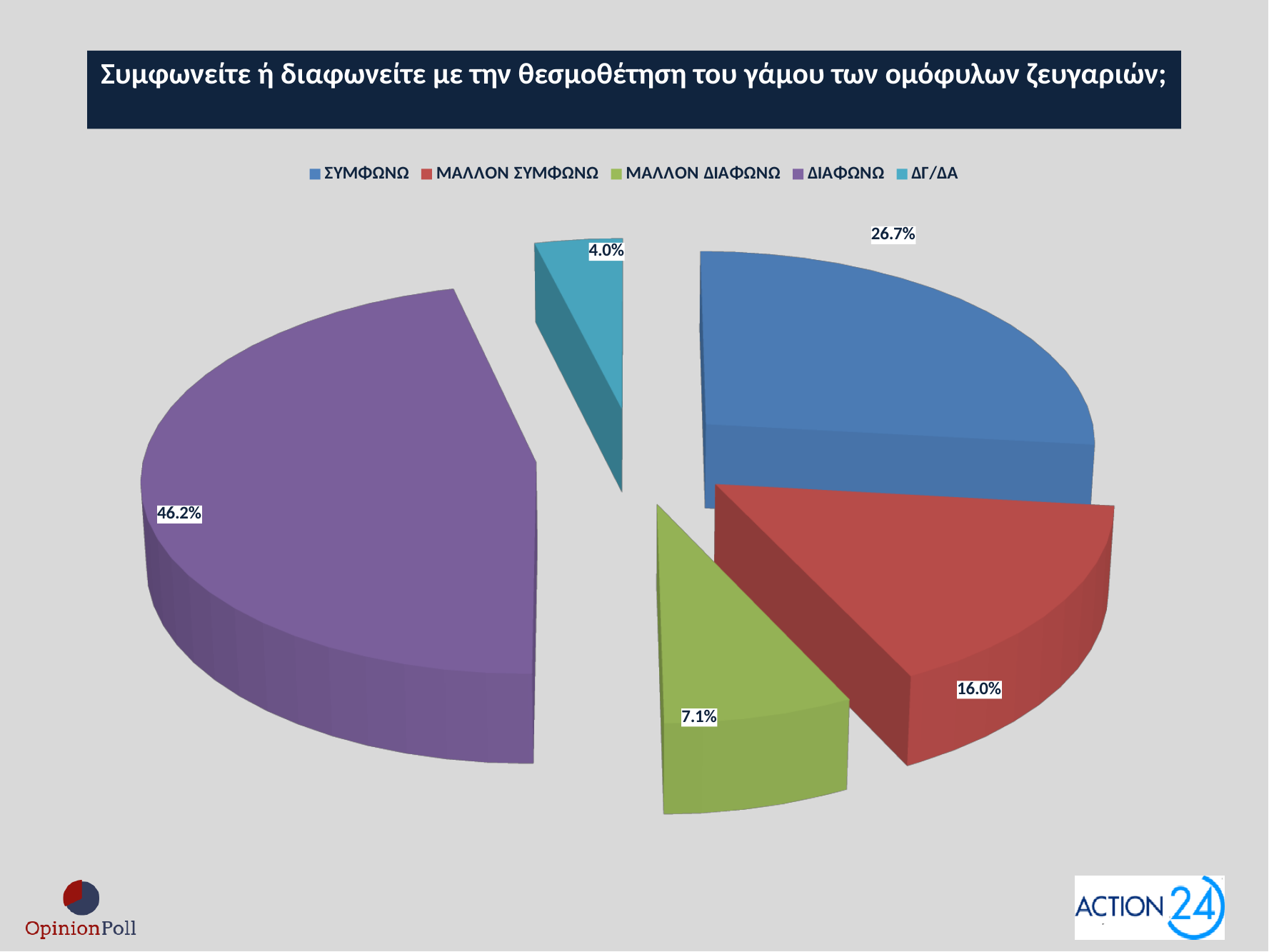
Which is larger, the value for ΜΑΛΛΟΝ ΣΥΜΦΩΝΩ or the value for ΜΑΛΛΟΝ ΔΙΑΦΩΝΩ? ΜΑΛΛΟΝ ΣΥΜΦΩΝΩ What is the value for ΔΓ/ΔΑ? 4.0% Which category has the largest share of the pie? ΔΙΑΦΩΝΩ What is the value for ΔΙΑΦΩΝΩ? 46.2% What is the value for ΜΑΛΛΟΝ ΣΥΜΦΩΝΩ? 16.0% How many categories does the legend list? 5 Which category has the smallest share of the pie? ΔΓ/ΔΑ What is the value for ΜΑΛΛΟΝ ΔΙΑΦΩΝΩ? 7.1% What is the value for ΣΥΜΦΩΝΩ? 26.7% What colour is the slice for ΔΙΑΦΩΝΩ? Purple What is the difference between the values for ΔΙΑΦΩΝΩ and ΣΥΜΦΩΝΩ? 19.5% What kind of chart is shown on the slide? Pie chart